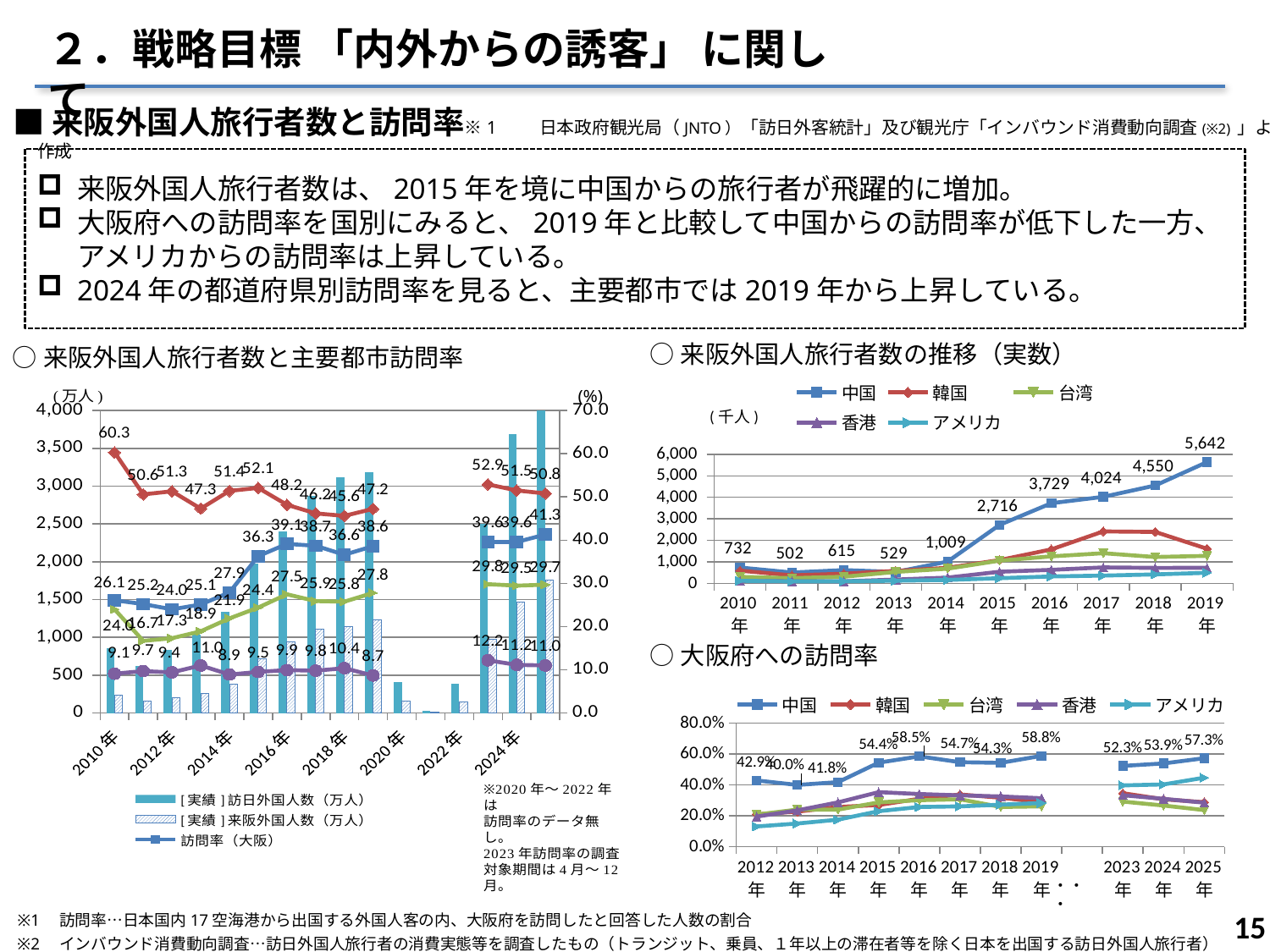
In the chart titled 来阪外国人旅行者数の推移（実数）, how many years are shown on the x axis? 10 In the chart titled 大阪府への訪問率, what is the value for 中国 in 2016年? 58.5% In the chart titled 来阪外国人旅行者数の推移（実数）, what is the value for 中国 in 2015年? 2,716 What kind of chart is the chart titled 大阪府への訪問率? line chart In the chart titled 来阪外国人旅行者数の推移（実数）, what is the value for 中国 in 2019年? 5,642 In the chart titled 大阪府への訪問率, in which year is the value for 中国 lowest? 2013年 In the chart titled 大阪府への訪問率, is the value for 韓国 in 2019年 greater or less than 40.0%? less In the chart titled 来阪外国人旅行者数の推移（実数）, how many series does the legend list? 5 In the chart titled 来阪外国人旅行者数の推移（実数）, which series has the larger value in 2019年, 中国 or 韓国? 中国 In the chart titled 来阪外国人旅行者数の推移（実数）, in which year is the value for 中国 lowest? 2011年 In the chart titled 来阪外国人旅行者数の推移（実数）, in which year is the value for 中国 highest? 2019年 In the chart titled 来阪外国人旅行者数の推移（実数）, what is the difference between the 中国 values for 2019年 and 2018年? 1,092